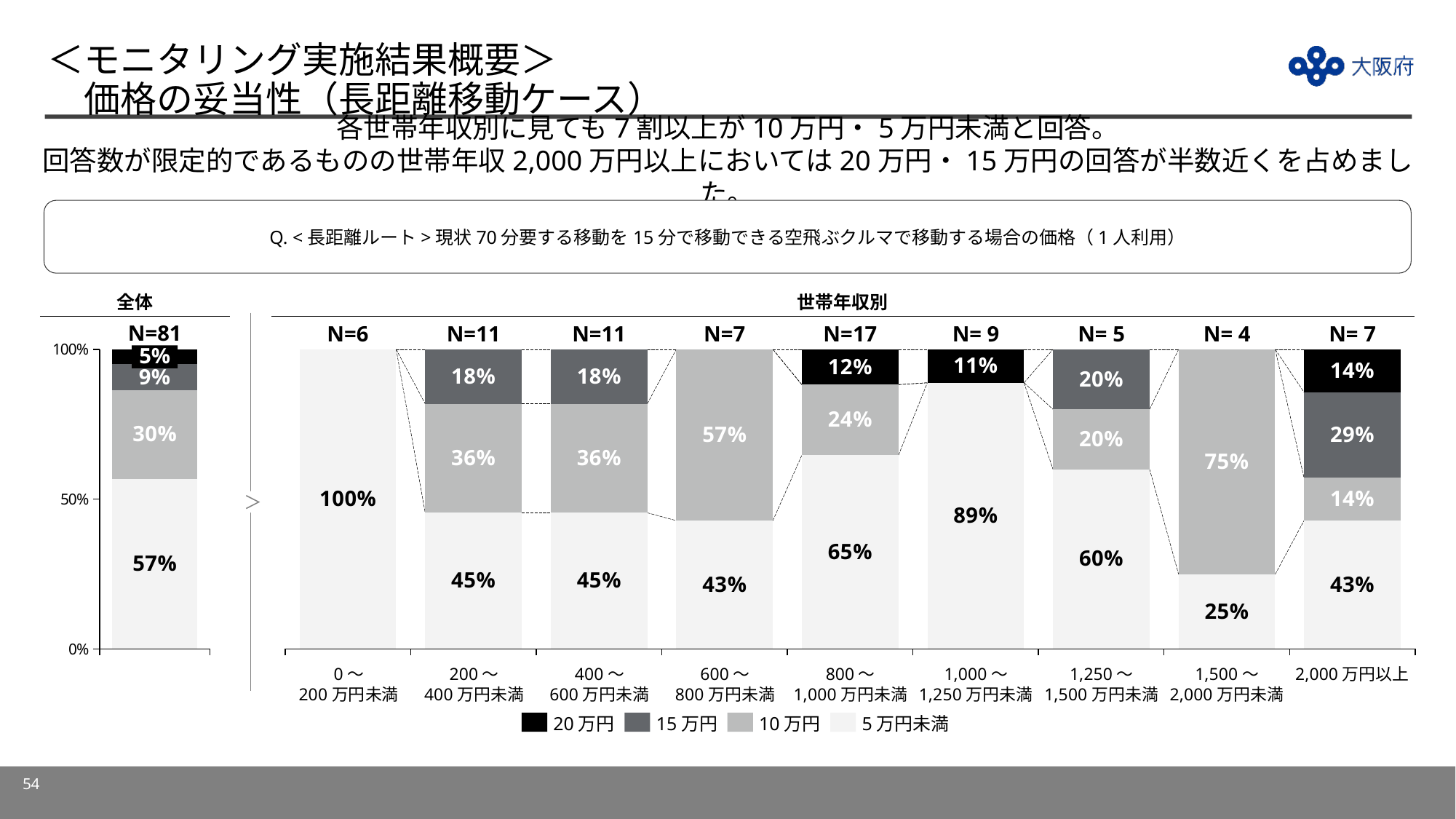
In the 世帯年収別 chart, what is the 10万円 share for the 1,500〜2,000万円未満 group? 75% In the 世帯年収別 chart, what is the 5万円未満 share for the 800〜1,000万円未満 group? 65% In the 世帯年収別 chart, what is the 15万円 share for the 2,000万円以上 group? 29% In the 全体 chart, what share of respondents answered 5万円未満? 57% In the 世帯年収別 chart, is the 5万円未満 share larger for the 1,000〜1,250万円未満 group or the 1,250〜1,500万円未満 group? 1,000〜1,250万円未満 What kind of chart is the 世帯年収別 chart? Stacked bar chart In the 世帯年収別 chart, which income group has the highest 5万円未満 share? 0〜200万円未満 In the 世帯年収別 chart, which income group has the lowest 5万円未満 share? 1,500〜2,000万円未満 In the 全体 chart, what share of respondents answered 10万円? 30% How many income groups are shown in the 世帯年収別 chart? 9 In the 全体 chart, what is the difference between the 5万円未満 share and the 10万円 share? 27% How many series does the legend list? 4